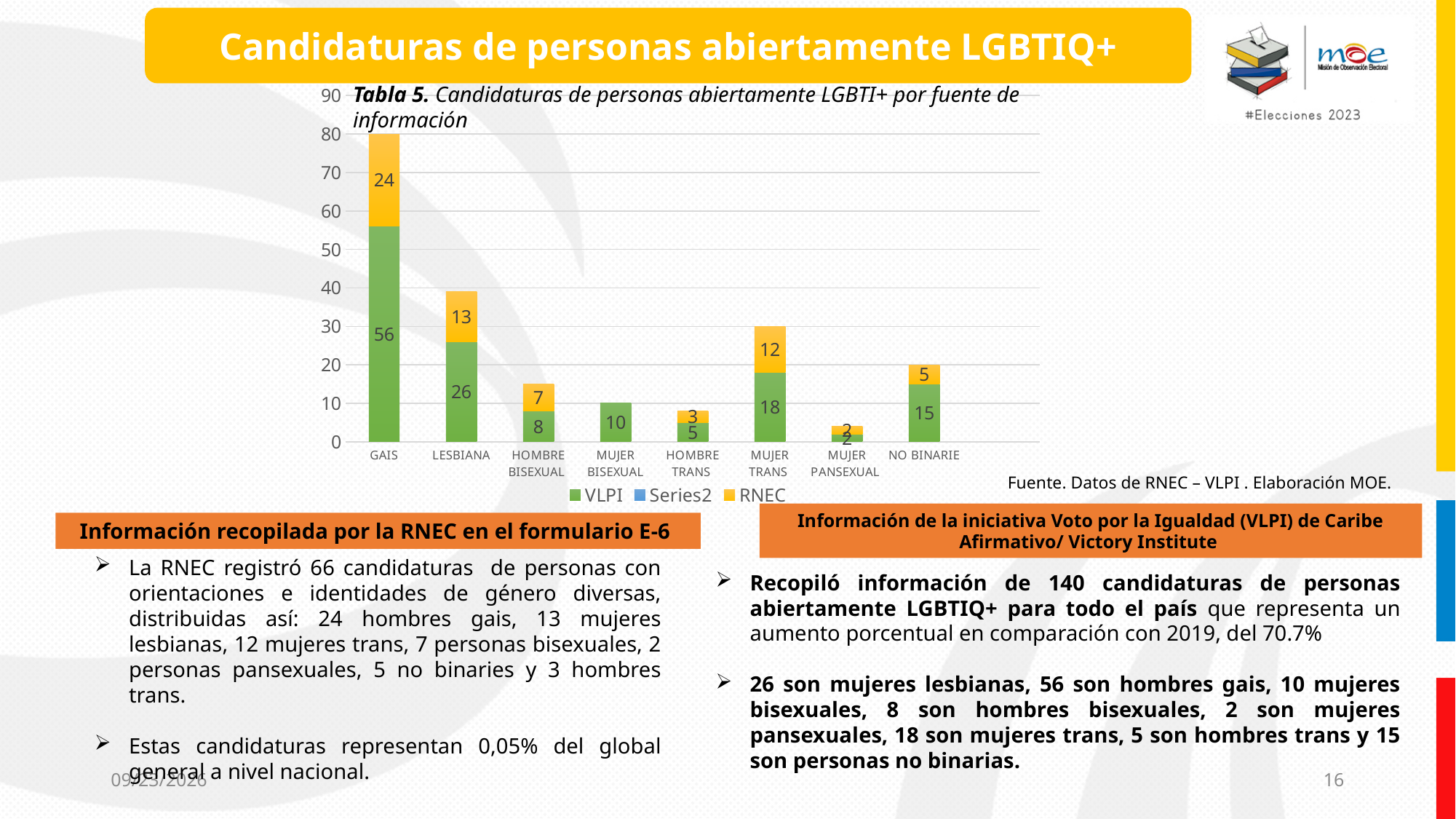
Which category has the highest VLPI value? GAIS How many categories are shown on the x axis? 8 How many series does the legend list? 3 What is the VLPI value for MUJER TRANS? 18 Which category has the lowest VLPI value? MUJER PANSEXUAL Which is larger, the VLPI value for HOMBRE BISEXUAL or the VLPI value for NO BINARIE? NO BINARIE What kind of chart is shown on the slide? Stacked bar chart What is the RNEC value for LESBIANA? 13 What is the difference between the VLPI and RNEC values for GAIS? 32 What is the VLPI value for GAIS? 56 What is the total of the stacked bar for LESBIANA? 39 What is the RNEC value for NO BINARIE? 5